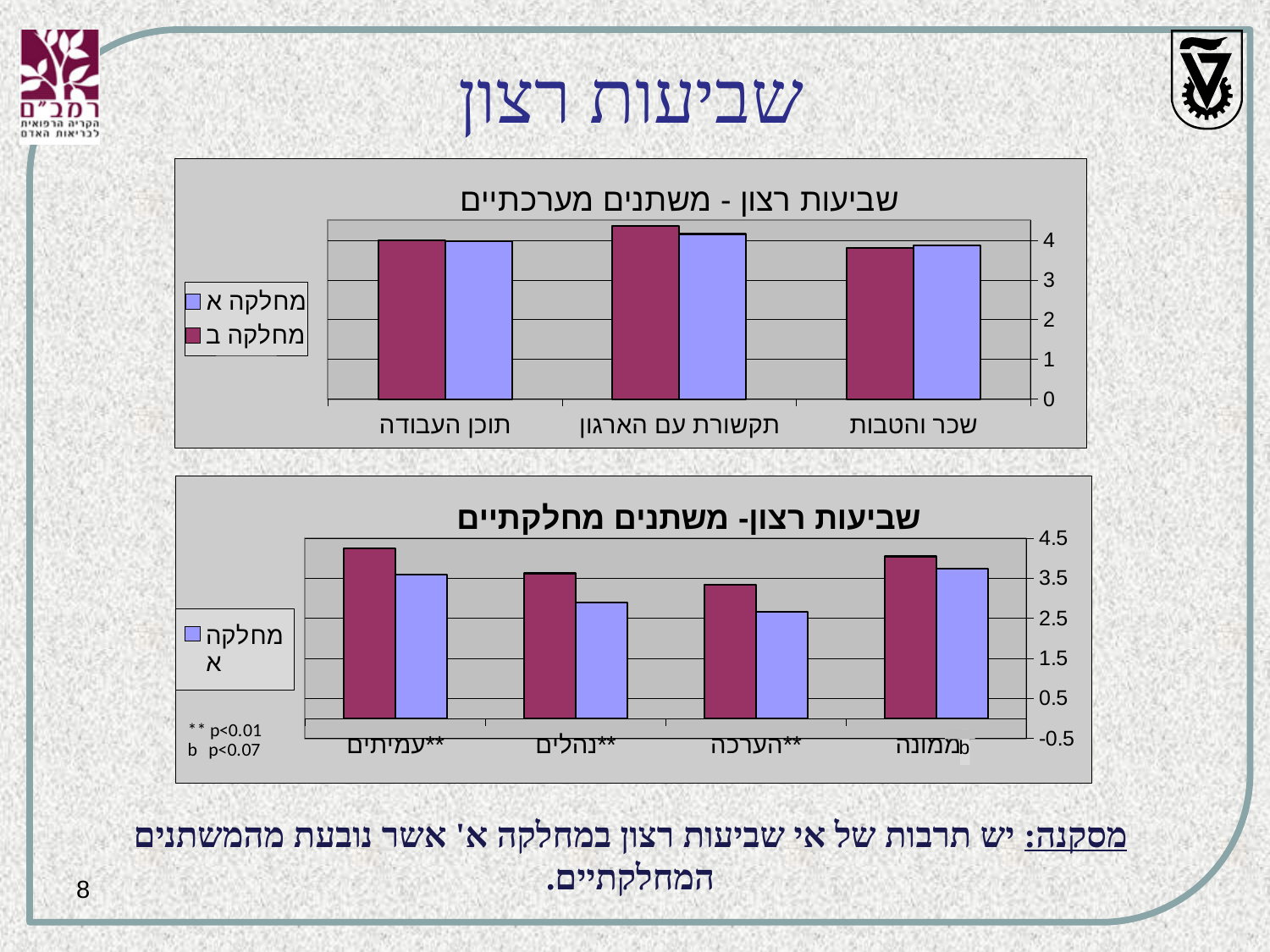
In the top chart "שביעות רצון - משתנים מערכתיים", is the value of מחלקה ב for שכר והטבות greater or less than 4? less In the top chart "שביעות רצון - משתנים מערכתיים", which category has the highest value for מחלקה ב? תקשורת עם הארגון In the bottom chart "שביעות רצון- משתנים מחלקתיים", is the maroon bar for עמיתים** greater or less than 3.5? greater In the bottom chart "שביעות רצון- משתנים מחלקתיים", for הערכה**, which is larger: the maroon bar or the blue bar (מחלקה א)? the maroon bar In the top chart "שביעות רצון - משתנים מערכתיים", which category has the lowest value for מחלקה ב? שכר והטבות How many categories are shown on the x axis of the bottom chart "שביעות רצון- משתנים מחלקתיים"? 4 In the bottom chart "שביעות רצון- משתנים מחלקתיים", which category has the lowest value for the maroon series? הערכה** In the bottom chart "שביעות רצון- משתנים מחלקתיים", is the value of מחלקה א for נהלים** greater or less than 3.5? less What kind of chart is the top chart titled "שביעות רצון - משתנים מערכתיים"? bar chart How many categories are shown on the x axis of the top chart "שביעות רצון - משתנים מערכתיים"? 3 How many series does the legend of the top chart "שביעות רצון - משתנים מערכתיים" list? 2